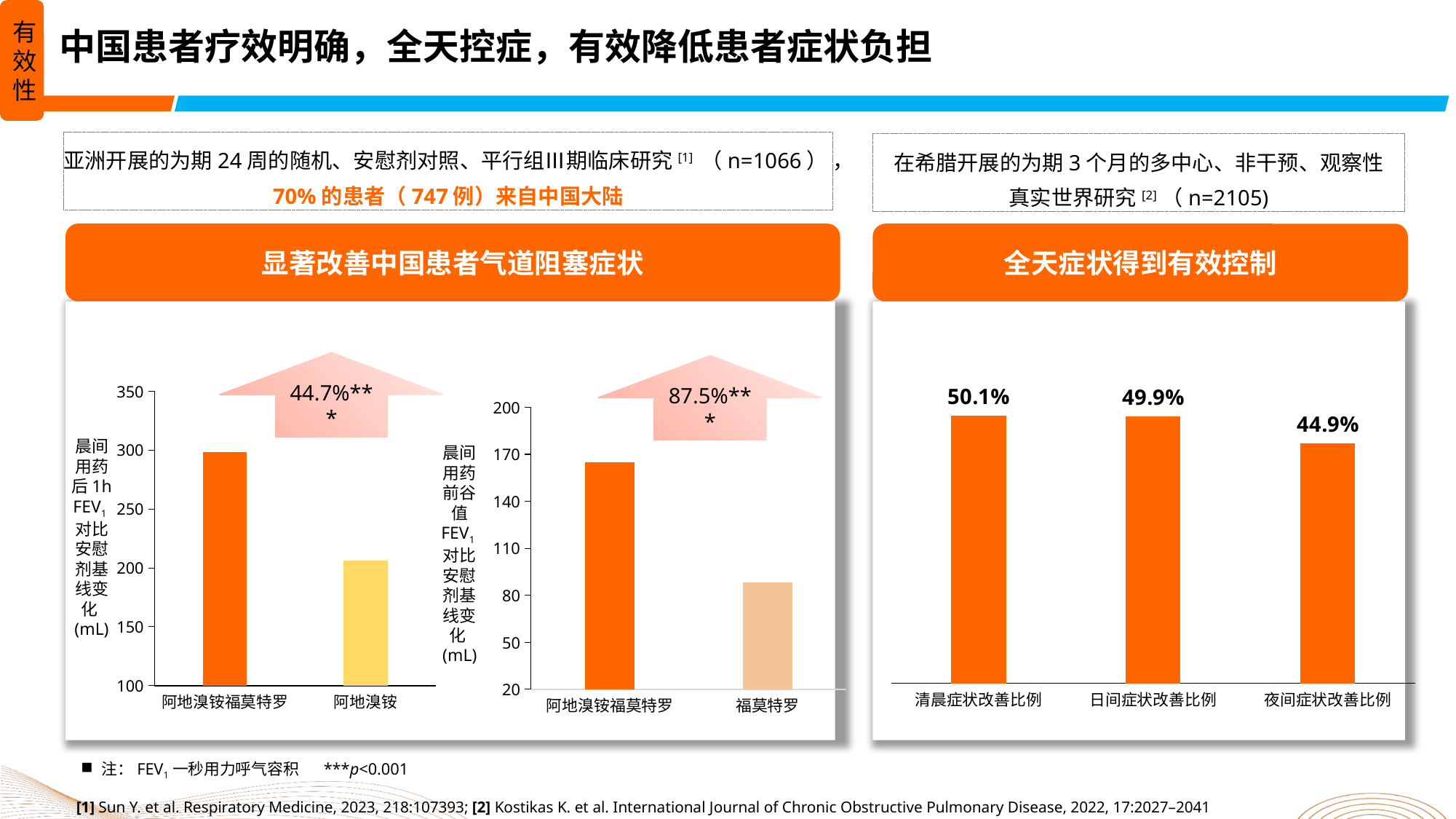
In the chart titled 全天症状得到有效控制, which category has the highest value? 清晨症状改善比例 In the chart titled 全天症状得到有效控制, what is the value for 夜间症状改善比例? 44.9% In the leftmost chart (晨间用药后1h FEV1 对比安慰剂基线变化), is the value for 阿地溴铵 greater or less than 250? less In the middle chart (晨间用药前谷值 FEV1 对比安慰剂基线变化), which of the two bars is taller, 阿地溴铵福莫特罗 or 福莫特罗? 阿地溴铵福莫特罗 In the chart titled 全天症状得到有效控制, how many categories are shown? 3 In the chart titled 全天症状得到有效控制, what is the difference between 清晨症状改善比例 and 夜间症状改善比例? 5.2% In the middle chart (晨间用药前谷值 FEV1 对比安慰剂基线变化), is the value for 福莫特罗 greater or less than 110? less In the leftmost chart (晨间用药后1h FEV1 对比安慰剂基线变化), is the value for 阿地溴铵福莫特罗 greater or less than 250? greater What percentage is shown in the arrow annotation above the middle chart (晨间用药前谷值 FEV1)? 87.5%*** In the chart titled 全天症状得到有效控制, what kind of chart is it? bar chart In the chart titled 全天症状得到有效控制, what is the value for 清晨症状改善比例? 50.1% In the chart titled 全天症状得到有效控制, which category has the lowest value? 夜间症状改善比例